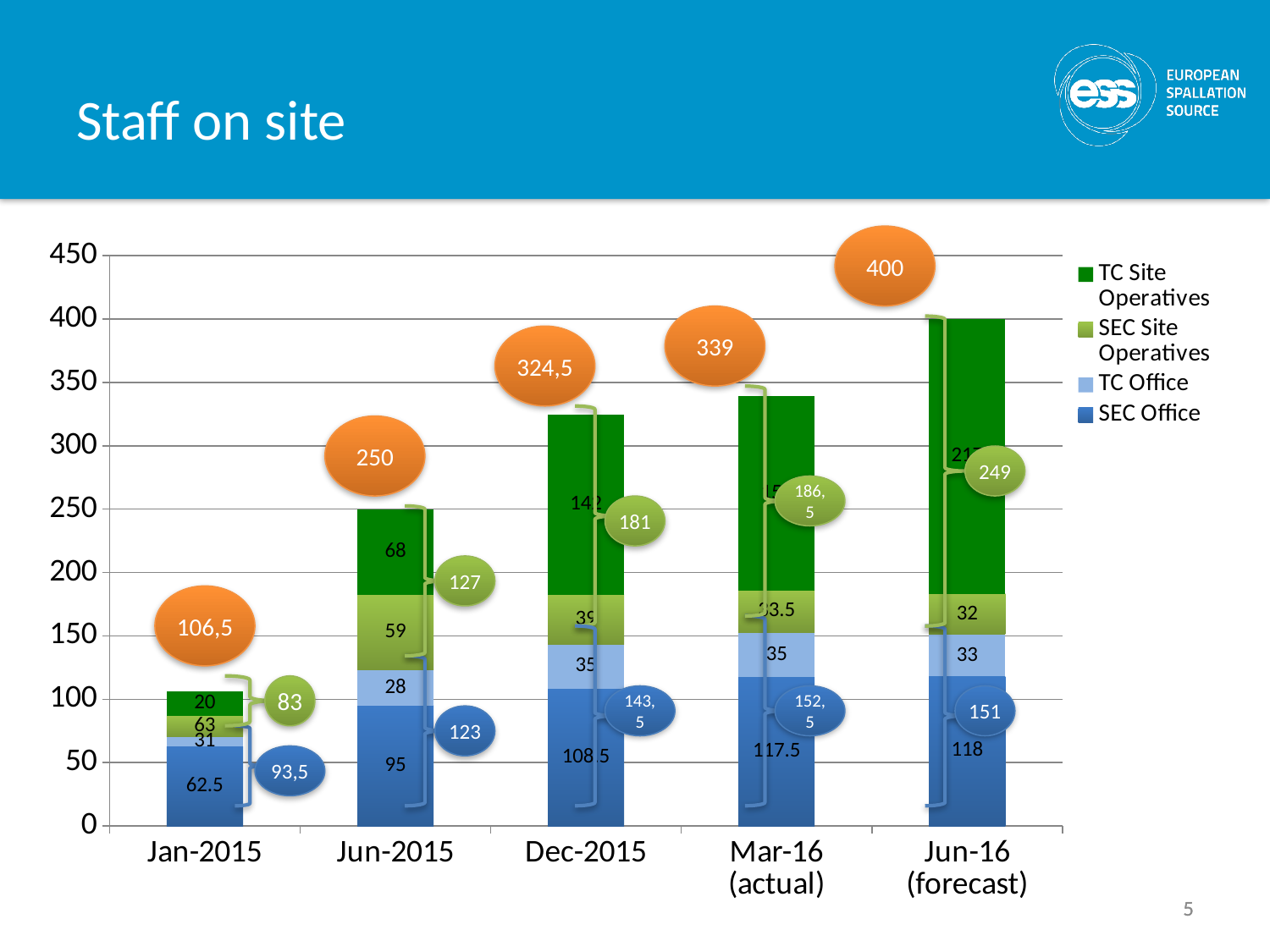
What is the SEC Site Operatives value for Jun-16 (forecast)? 32 What is the total staff on site shown for Dec-2015? 324,5 What type of chart is shown on the slide? Stacked bar chart What is the total staff on site shown for Jun-16 (forecast)? 400 Do the total staff on site values rise or fall from Jan-2015 to Jun-16 (forecast)? Rise Which period has the highest total staff on site? Jun-16 (forecast) What is the SEC Office value for Jun-2015? 95 Which period has the lowest total staff on site? Jan-2015 What is the difference between the total for Jun-16 (forecast) and the total for Mar-16 (actual)? 61 What is the TC Office value for Mar-16 (actual)? 35 How many time periods are shown on the x axis? 5 How many series does the legend list? 4